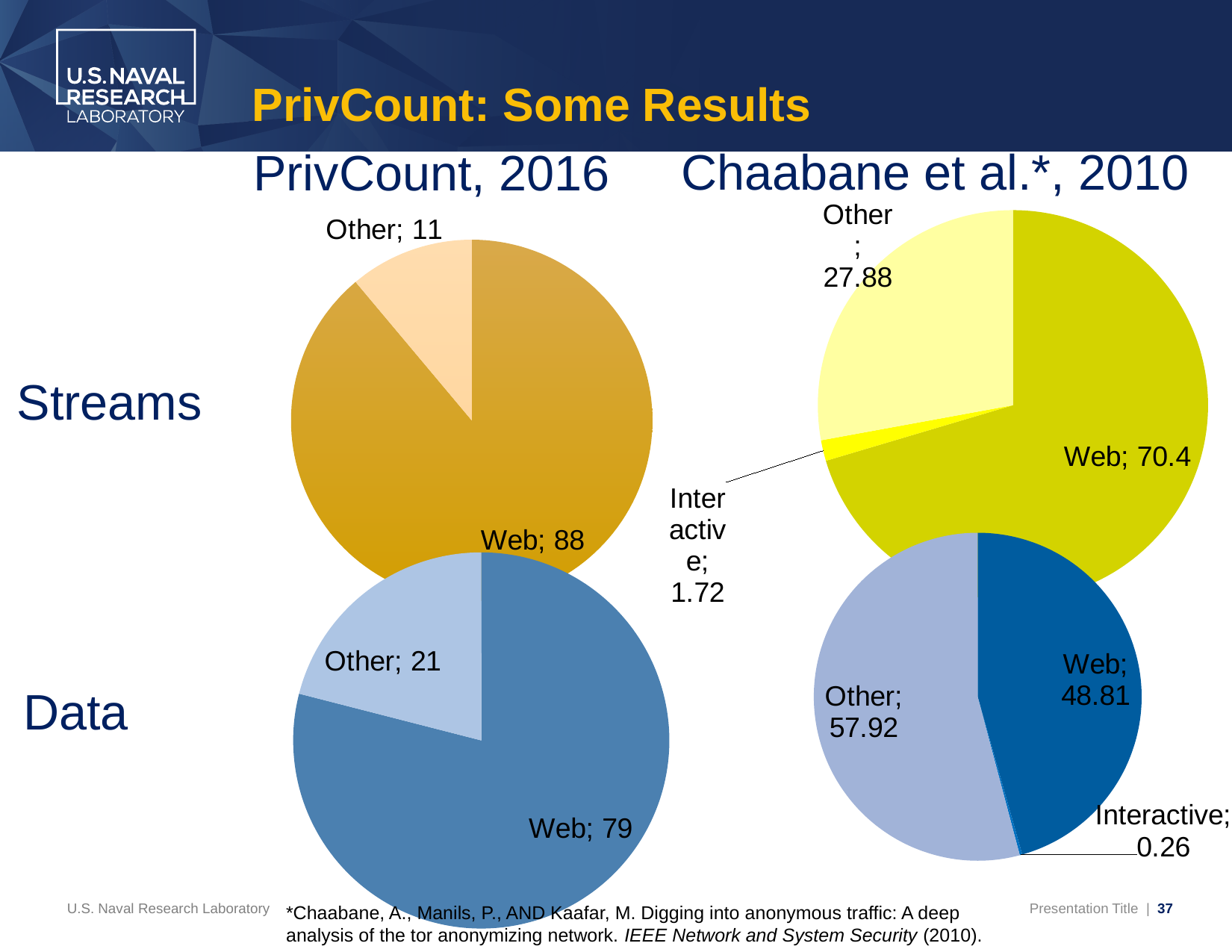
In the PrivCount, 2016 Data pie chart (bottom left), what is the difference between the Web and Other values? 58 In the Chaabane et al., 2010 Streams pie chart (top right), what is the value for Interactive? 1.72 In the Chaabane et al., 2010 Data pie chart (bottom right), which is larger, Web or Other? Other What kind of chart is used for the PrivCount, 2016 Streams data (top left)? Pie chart In the PrivCount, 2016 Data pie chart (bottom left), what is the value for Other? 21 In the Chaabane et al., 2010 Streams pie chart (top right), which category has the smallest slice? Interactive In the PrivCount, 2016 Streams pie chart (top left), what is the value for Web? 88 In the Chaabane et al., 2010 Data pie chart (bottom right), which category has the largest slice? Other In the Chaabane et al., 2010 Data pie chart (bottom right), what is the value for Other? 57.92 In the PrivCount, 2016 Streams pie chart (top left), what is the value for Other? 11 How many pie charts are shown on the slide? 4 How many slices does the Chaabane et al., 2010 Streams pie chart (top right) have? 3